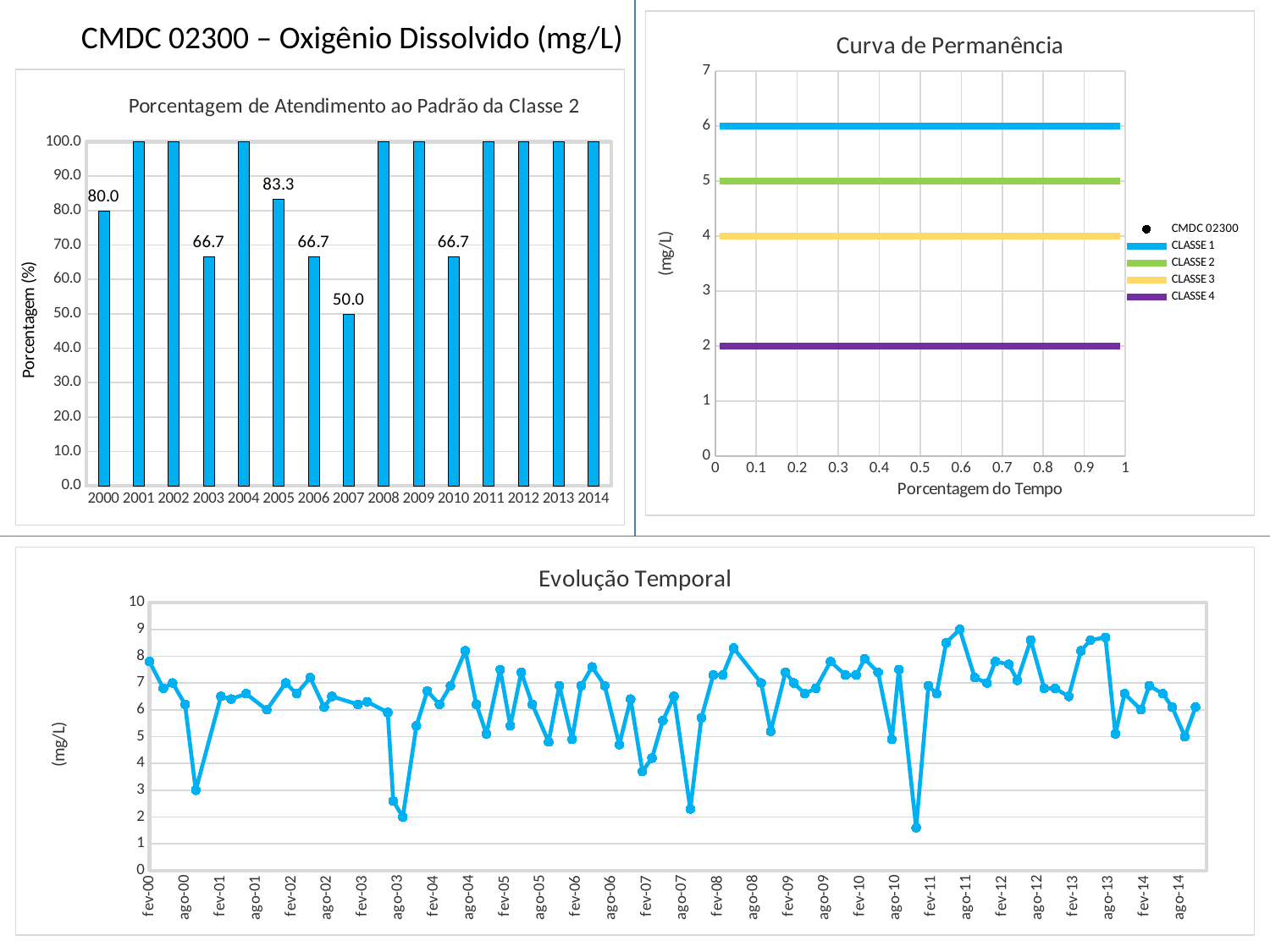
In the chart 'Porcentagem de Atendimento ao Padrão da Classe 2', what is the value for 2000? 80.0 In the chart 'Porcentagem de Atendimento ao Padrão da Classe 2', which is larger, the value for 2000 or the value for 2003? 2000 In the chart 'Porcentagem de Atendimento ao Padrão da Classe 2', which year has the lowest value? 2007 In the chart 'Curva de Permanência', at what value (mg/L) is the CLASSE 2 line drawn? 5 In the chart 'Porcentagem de Atendimento ao Padrão da Classe 2', what is the value for 2005? 83.3 What kind of chart is 'Porcentagem de Atendimento ao Padrão da Classe 2'? bar chart In the chart 'Porcentagem de Atendimento ao Padrão da Classe 2', what is the difference between the values for 2005 and 2007? 33.3 In the chart 'Evolução Temporal', is the value for ago-00 greater or less than 4? greater In the chart 'Curva de Permanência', how many entries does the legend list? 5 In the chart 'Porcentagem de Atendimento ao Padrão da Classe 2', how many years are shown on the x axis? 15 In the chart 'Curva de Permanência', which class line is the lowest? CLASSE 4